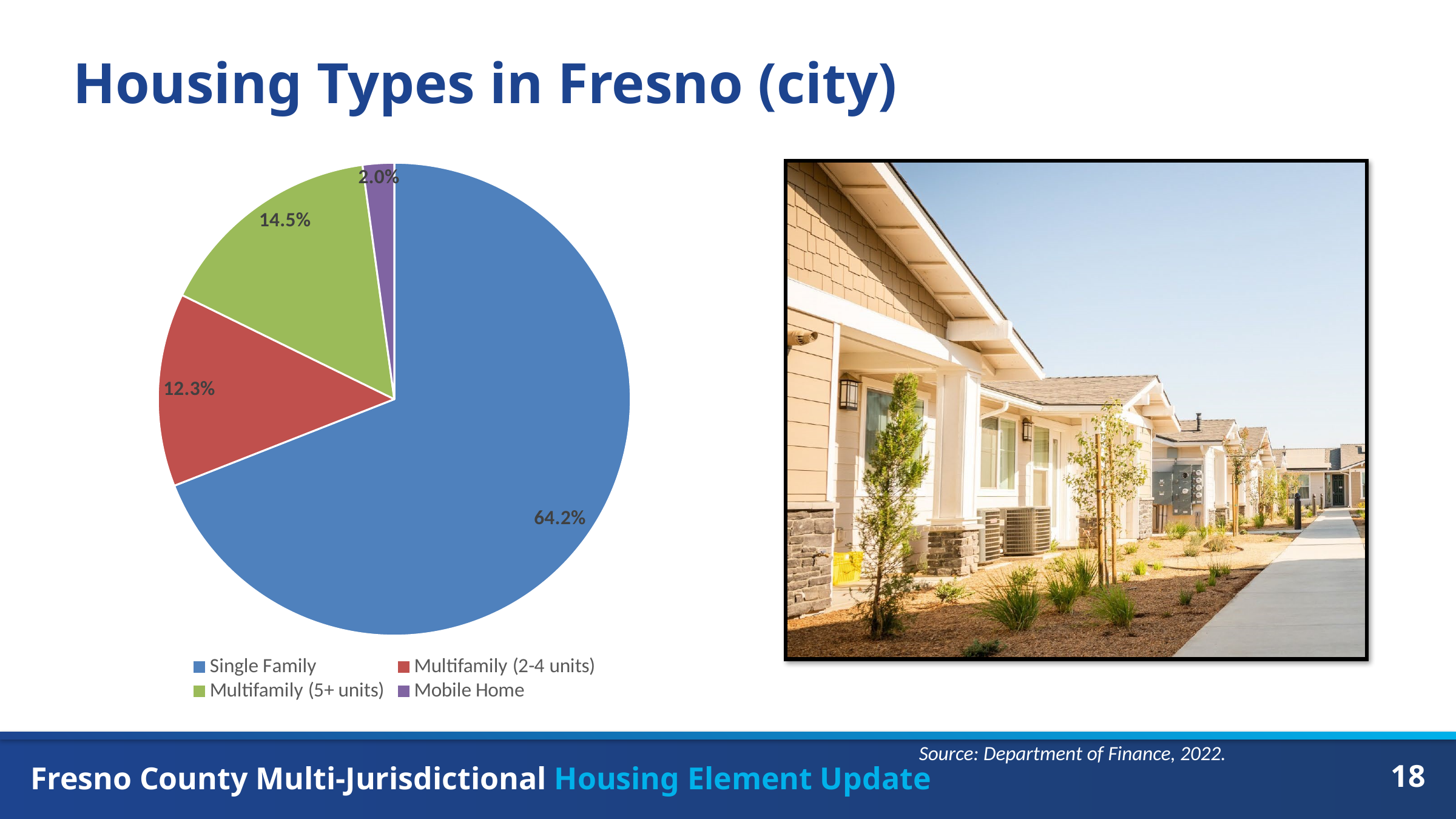
What is the combined share of the two Multifamily categories? 26.8% What is the difference in percentage points between the Single Family share and the Multifamily (5+ units) share? 49.7 How many housing types are shown in the pie chart? 4 Which housing type has the smallest share of the pie? Mobile Home What share of housing in Fresno (city) is Multifamily (5+ units)? 14.5% What share of housing in Fresno (city) is Multifamily (2-4 units)? 12.3% What colour is the Mobile Home slice in the pie chart? Purple What share of housing in Fresno (city) is Mobile Home? 2.0% What type of chart is shown on the slide? Pie chart Which housing type has the largest share of the pie? Single Family What share of housing in Fresno (city) is Single Family? 64.2% Which has a larger share: Multifamily (2-4 units) or Multifamily (5+ units)? Multifamily (5+ units)